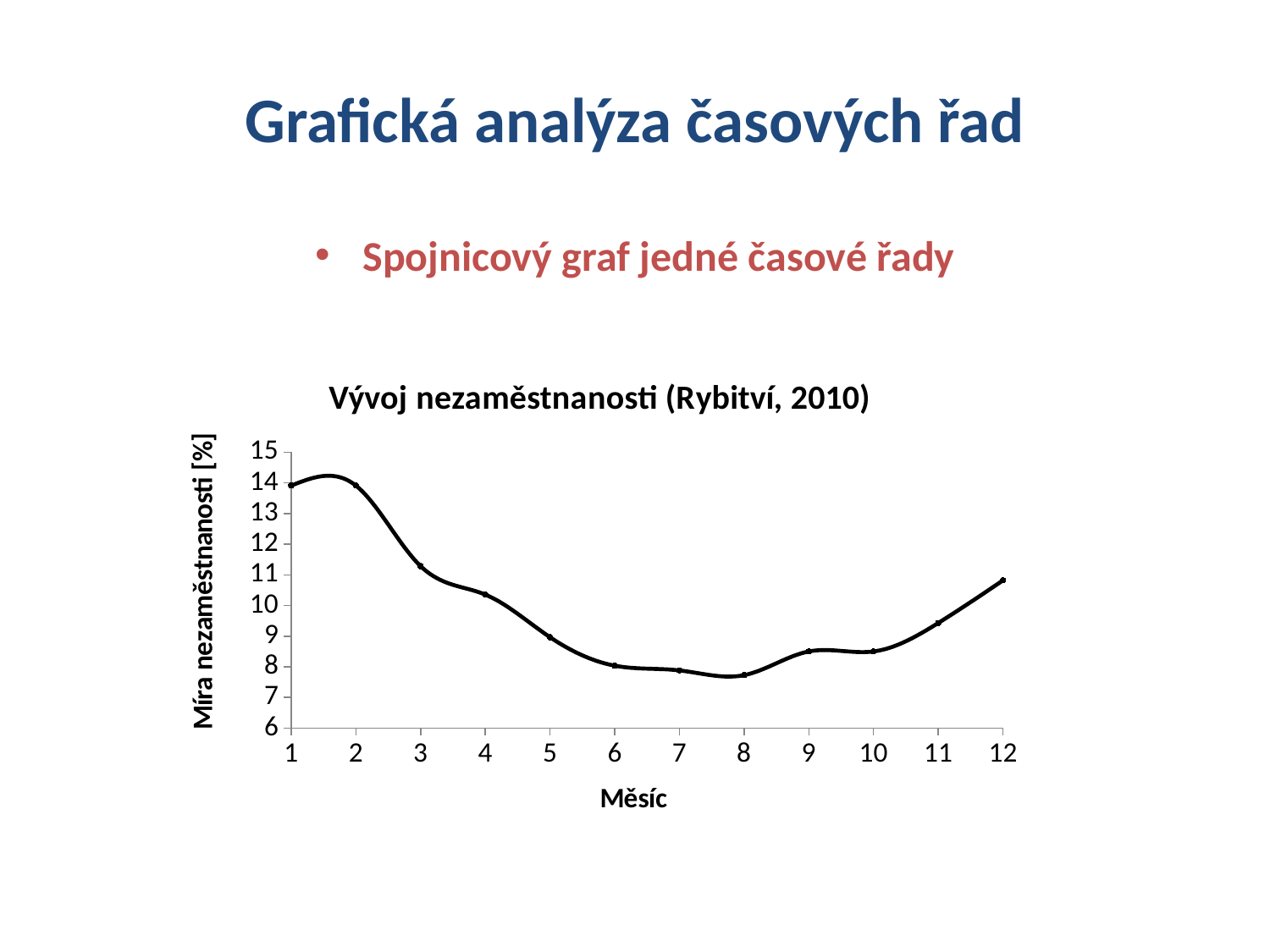
Is the value for month 3 greater or less than 12? less Is the value for month 12 greater or less than 10? greater Do the values rise or fall from month 1 to month 6? fall How many months (data points) are plotted on the chart? 12 Is the value for month 5 greater or less than 10? less What is the title of the chart? Vývoj nezaměstnanosti (Rybitví, 2010) What is the label of the x axis? Měsíc Which is larger, the value for month 1 or the value for month 12? month 1 Which is larger, the value for month 4 or the value for month 9? month 4 What kind of chart is shown on the slide? line chart